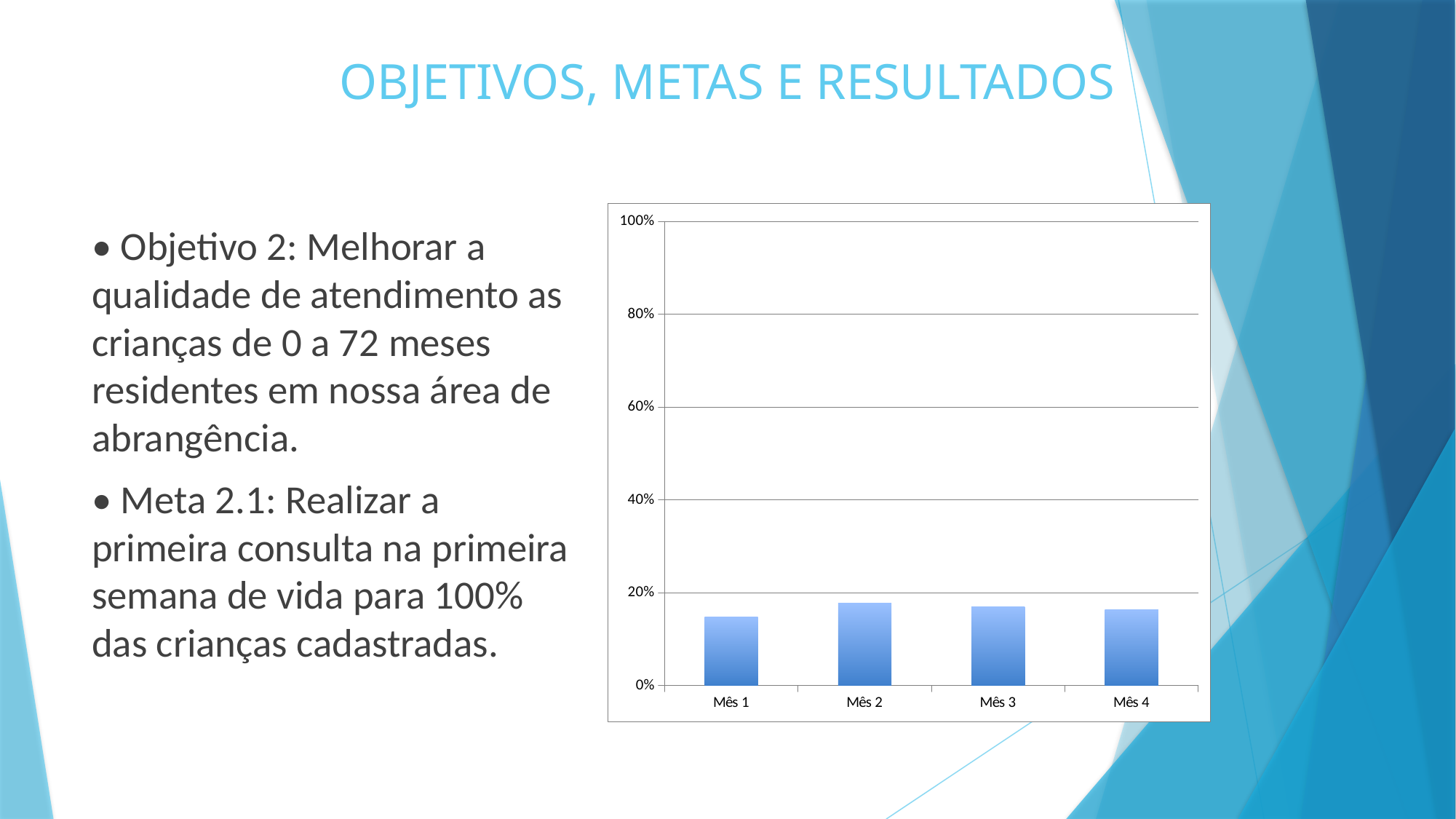
What is the highest value shown on the y axis of the chart? 100% Is the value for Mês 1 greater or less than 20%? less Is the value for Mês 3 greater or less than 40%? less Does the value rise or fall from Mês 1 to Mês 2? rise What kind of chart is shown on the slide? bar chart Is the value for Mês 4 greater or less than 20%? less How many categories are plotted on the x axis of the chart? 4 Which is larger, the value for Mês 1 or the value for Mês 4? Mês 4 What is the label of the first category on the x axis? Mês 1 Which is larger, the value for Mês 1 or the value for Mês 2? Mês 2 Which category has the lowest bar in the chart? Mês 1